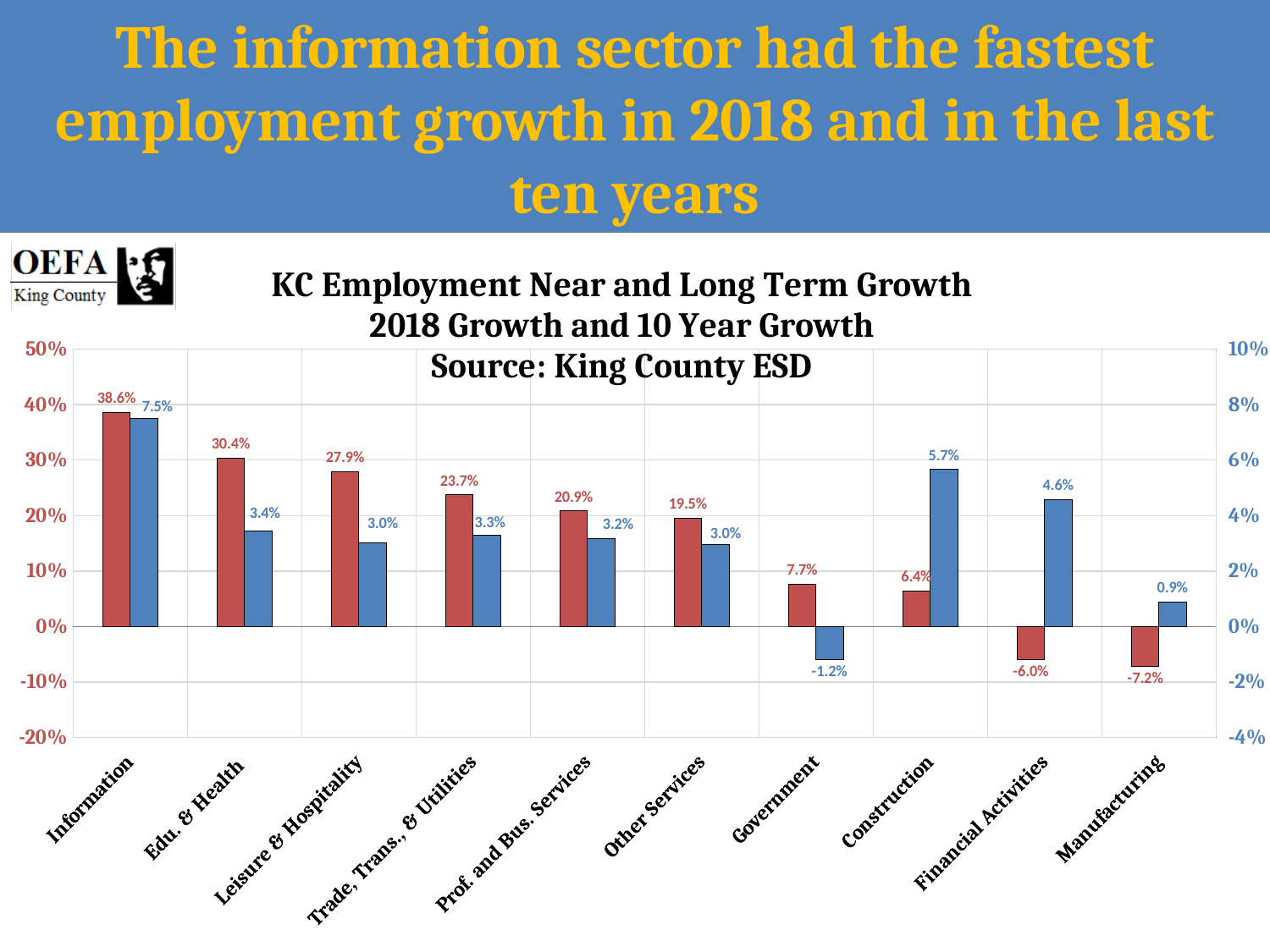
What is the value of the blue bar for Government? -1.2% What is the value of the blue bar for Construction? 5.7% What is the value of the red bar for Manufacturing? -7.2% What kind of chart is shown on the slide? bar chart Which category has the lowest blue bar? Government What is the difference between the red bar values for Edu. & Health and Leisure & Hospitality? 2.5% How many categories are shown on the x axis? 10 Which category has the highest red bar? Information What is the source cited in the chart title? King County ESD Is the red bar value for Government greater or less than 10%? less What is the value of the red bar for Information? 38.6% Which has a larger blue bar value, Financial Activities or Construction? Construction